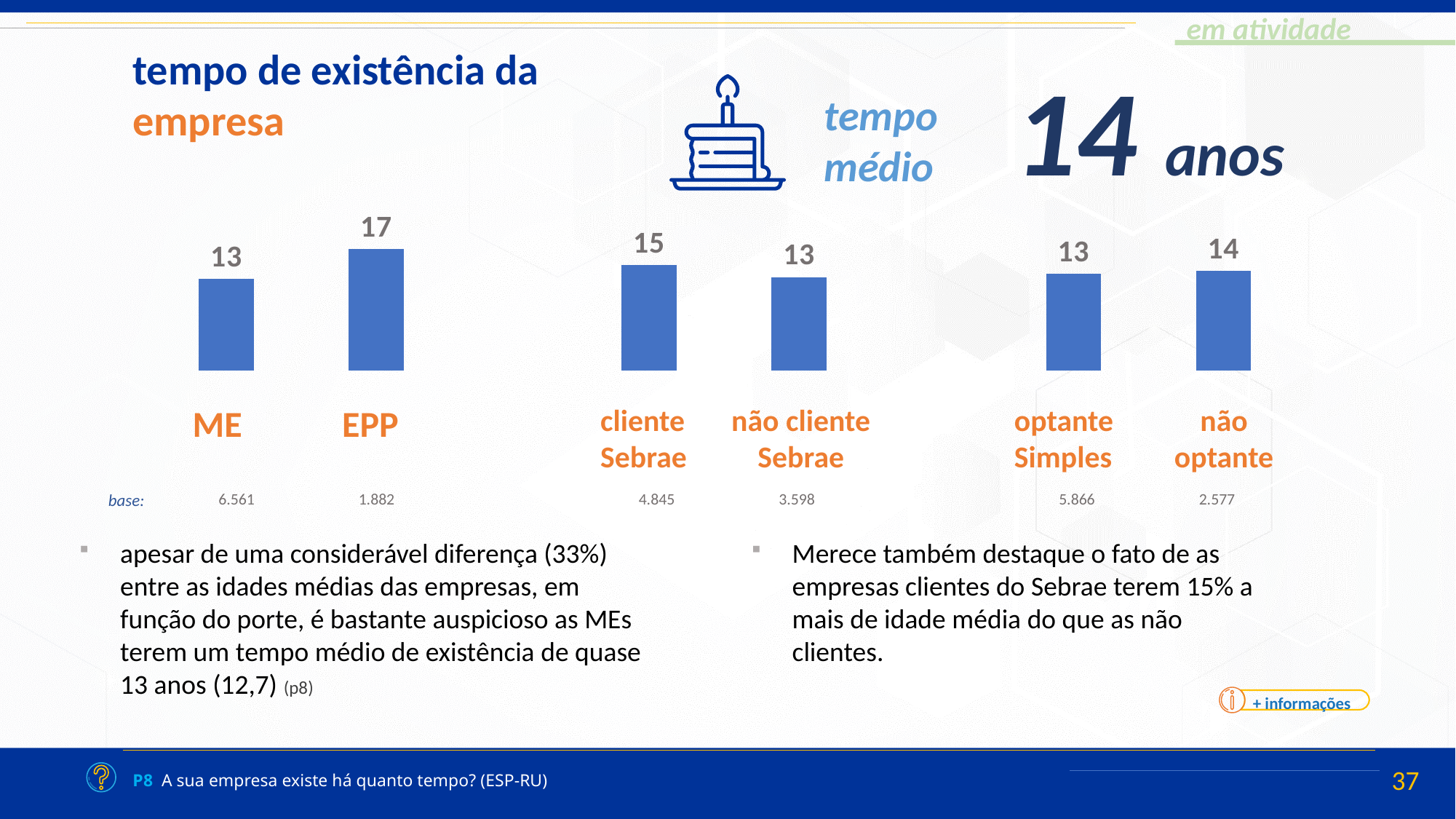
In the left chart (ME vs EPP), what is the value for EPP? 17 How many categories are shown in the left chart (ME vs EPP)? 2 In the right chart (optante Simples vs não optante), what is the value for não optante? 14 In the middle chart (cliente Sebrae vs não cliente Sebrae), what is the difference between the two values? 2 In the left chart (ME vs EPP), what is the difference between the EPP and ME values? 4 In the left chart (ME vs EPP), what is the value for ME? 13 In the left chart (ME vs EPP), which category has the higher value? EPP What kind of chart is used on this slide to show the values for ME and EPP? bar chart In the middle chart (cliente Sebrae vs não cliente Sebrae), what is the value for cliente Sebrae? 15 In the middle chart (cliente Sebrae vs não cliente Sebrae), what is the value for não cliente Sebrae? 13 In the right chart (optante Simples vs não optante), what is the value for optante Simples? 13 In the middle chart (cliente Sebrae vs não cliente Sebrae), which category has the lower value? não cliente Sebrae